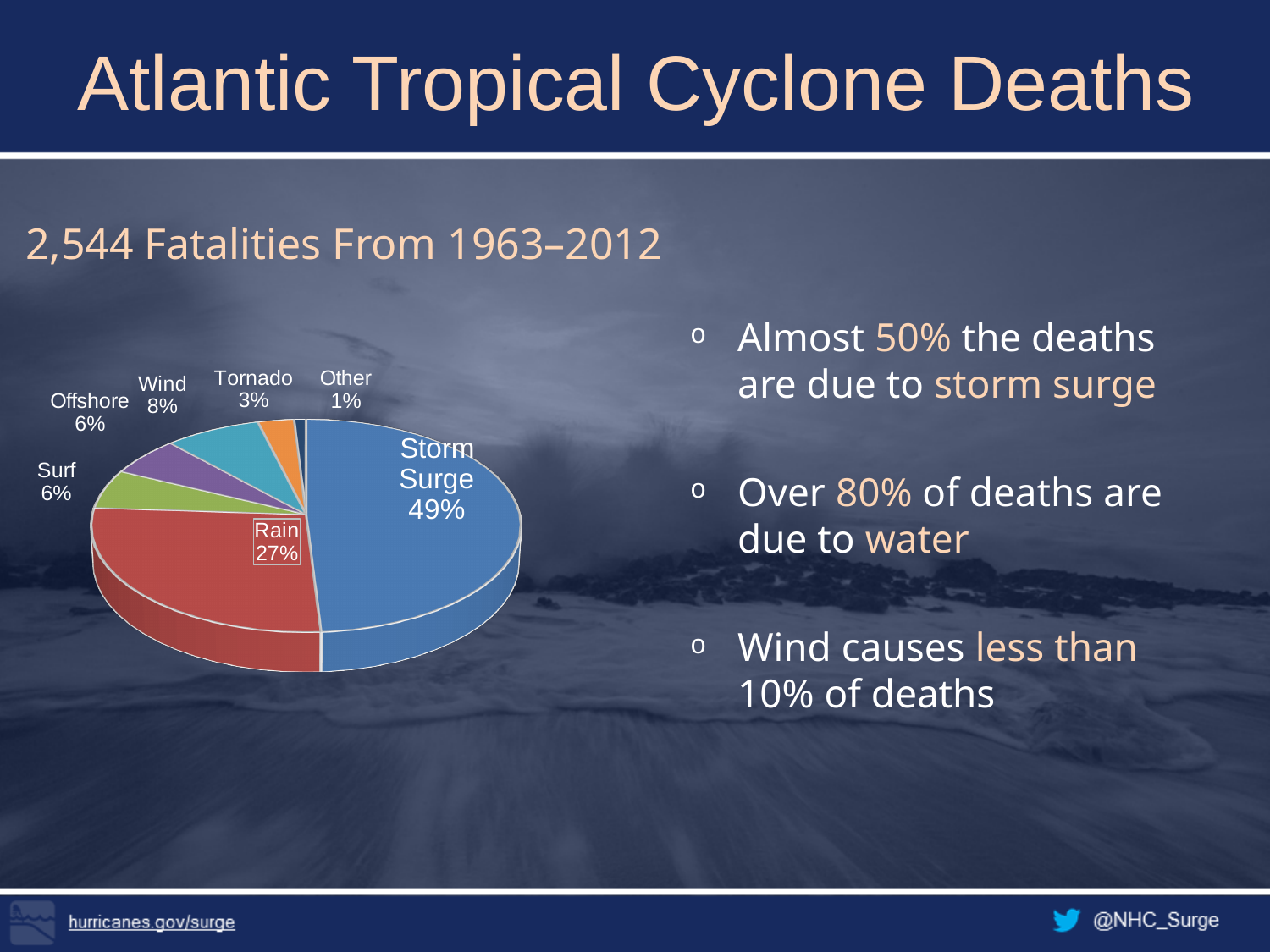
Which slice is larger, Wind or Surf? Wind What is the combined share of the Storm Surge and Rain slices? 76% What colour is the Storm Surge slice in the pie chart? Blue What type of chart is used on this slide? Pie chart How many percentage points larger is the Storm Surge share than the Rain share? 22 What share of deaths is due to Wind according to the pie chart? 8% Which category accounts for the largest share of deaths in the pie chart? Storm Surge How many categories are shown in the pie chart? 7 Which category has the smallest slice in the pie chart? Other What percentage is shown for the Tornado slice? 3% What percentage of deaths does the Rain slice represent? 27% What share of deaths is attributed to Storm Surge in the pie chart? 49%